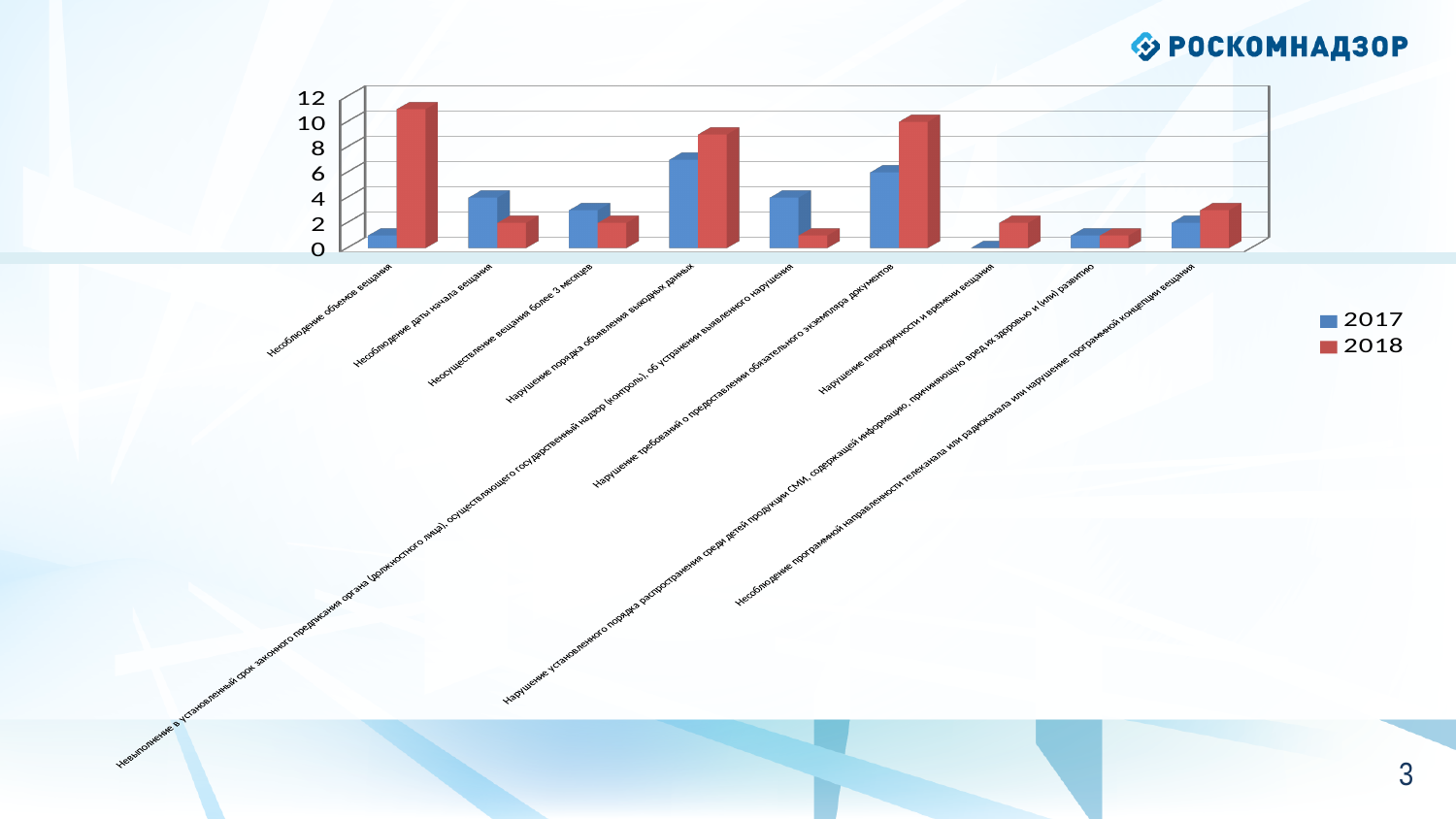
For "Несоблюдение объемов вещания", which series has the larger value, 2017 or 2018? 2018 Is the 2017 value for "Несоблюдение объемов вещания" greater or less than 2? less Which years are listed in the chart legend? 2017 and 2018 What kind of chart is shown on the slide? bar chart How many series does the chart legend list? 2 Is the 2017 value for "Нарушение порядка объявления выходных данных" greater or less than 4? greater For "Несоблюдение даты начала вещания", which series has the larger value, 2017 or 2018? 2017 Is the 2018 value for "Нарушение требований о предоставлении обязательного экземпляра документов" greater or less than 8? greater How many categories are plotted along the x axis of the chart? 9 Which series is shown in red in the chart? 2018 Which category has the lowest 2017 value in the chart? Нарушение периодичности и времени вещания